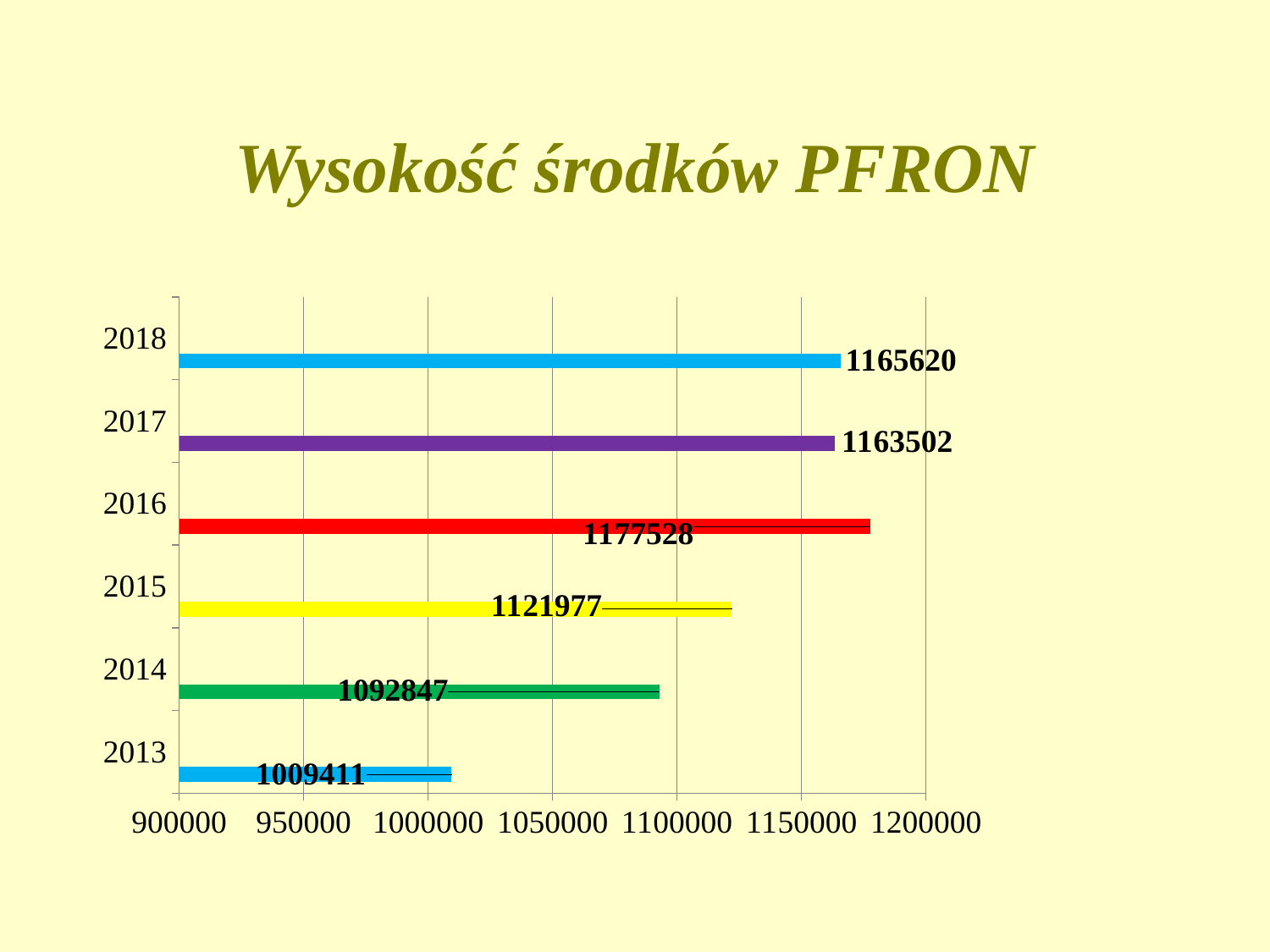
What is the difference between the values for 2018 and 2017? 2118 What is the title of the chart? Wysokość środków PFRON What is the value for 2013? 1009411 Which year has the lowest value? 2013 What kind of chart is shown on the slide? bar chart What is the value for 2015? 1121977 What is the difference between the values for 2016 and 2013? 168117 Which year has the highest value? 2016 Which is larger, the value for 2016 or the value for 2015? 2016 How many years are shown on the chart? 6 What is the value for 2018? 1165620 Is the value for 2013 greater or less than 1050000? less